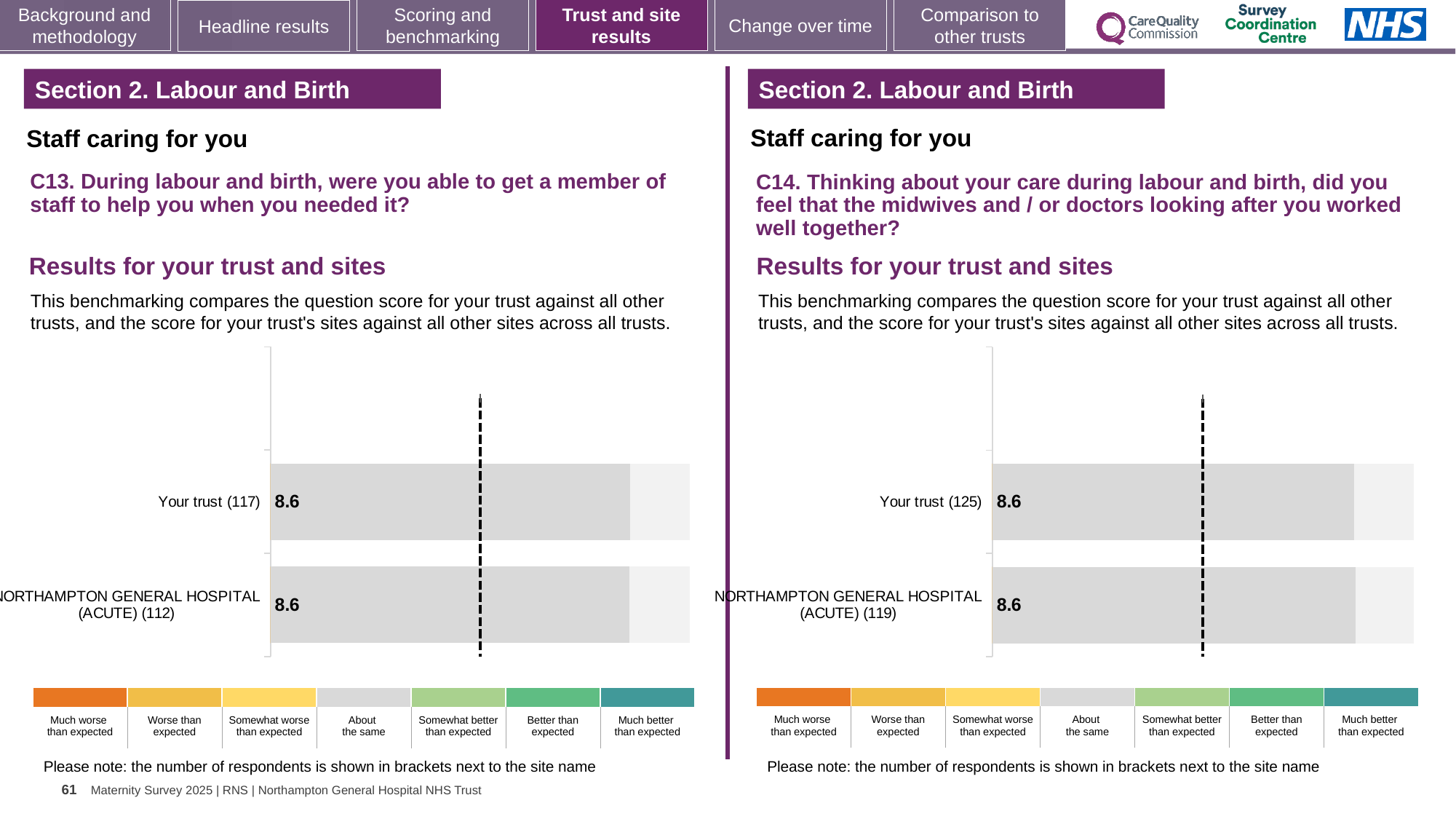
How many categories does the colour key below the C13 chart on the left list? 7 In the colour key below the C14 chart on the right, what colour represents 'Much worse than expected'? Orange In the C14 chart on the right, what is the difference between the score for Your trust (125) and the score for NORTHAMPTON GENERAL HOSPITAL (ACUTE) (119)? 0 In the C13 chart on the left, what is the difference between the score for Your trust (117) and the score for NORTHAMPTON GENERAL HOSPITAL (ACUTE) (112)? 0 In the C13 chart on the left, what is the score for NORTHAMPTON GENERAL HOSPITAL (ACUTE) (112)? 8.6 In the C14 chart on the right, what is the score for Your trust (125)? 8.6 How many bars are plotted in the C14 chart on the right? 2 In the C14 chart on the right, what is the score for NORTHAMPTON GENERAL HOSPITAL (ACUTE) (119)? 8.6 In the C13 chart on the left, what is the score for Your trust (117)? 8.6 What kind of chart is used for the C14 results on the right? Bar chart How many bars are plotted in the C13 chart on the left? 2 What kind of chart is used for the C13 results on the left? Bar chart